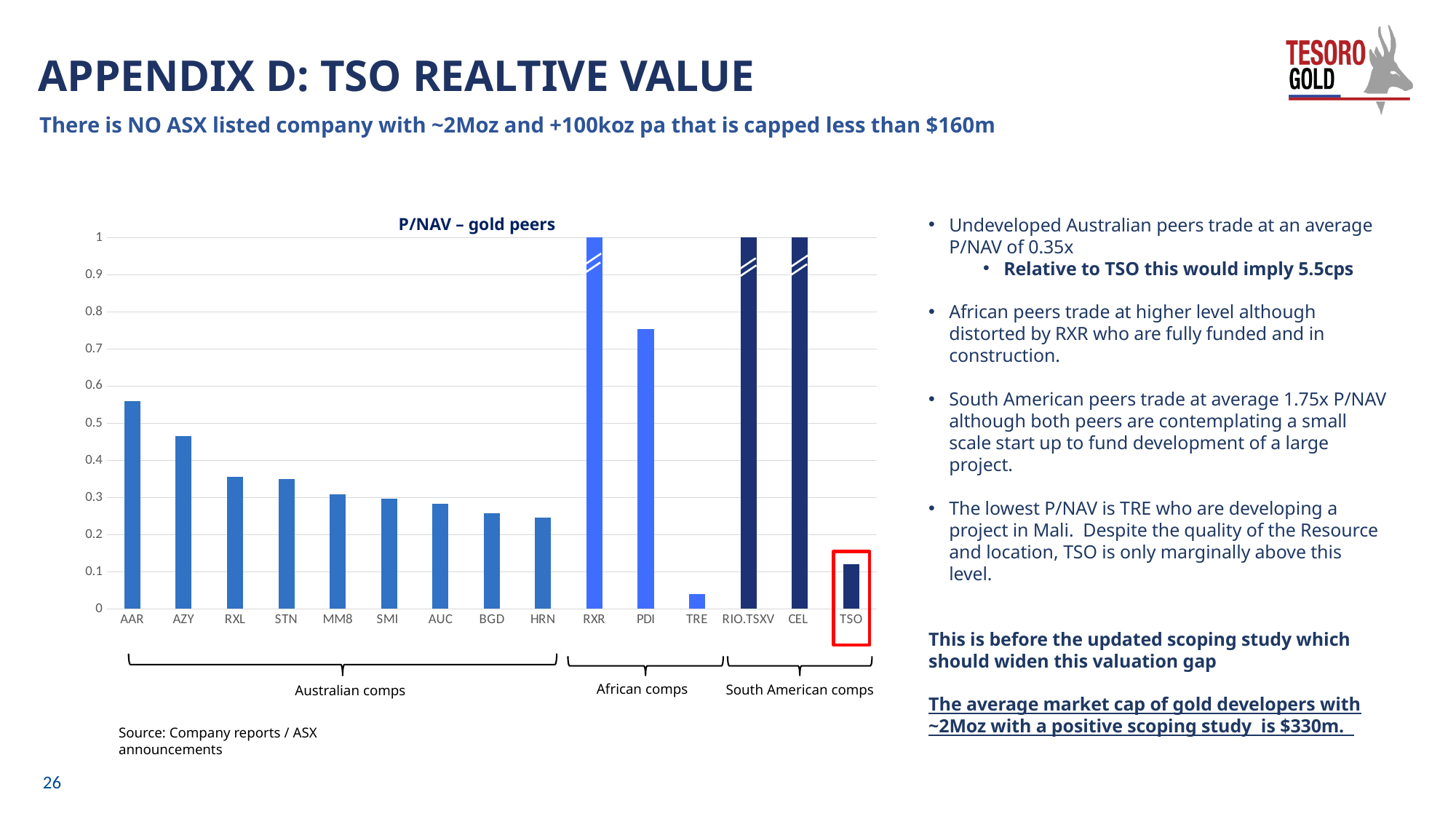
Is the value for HRN greater or less than 0.3? less Which has the larger P/NAV, AAR or AZY? AAR Which company has the lowest P/NAV in the chart? TRE Do the values rise or fall across the Australian comps from AAR to HRN? fall Is the value for TSO greater or less than 0.2? less Which has the larger P/NAV, TSO or TRE? TSO How many companies are plotted on the x axis of the chart? 15 Is the value for AAR greater or less than 0.5? greater Which company's bar is outlined with a red box in the chart? TSO What is the title of the chart? P/NAV – gold peers What kind of chart is shown on the slide? bar chart